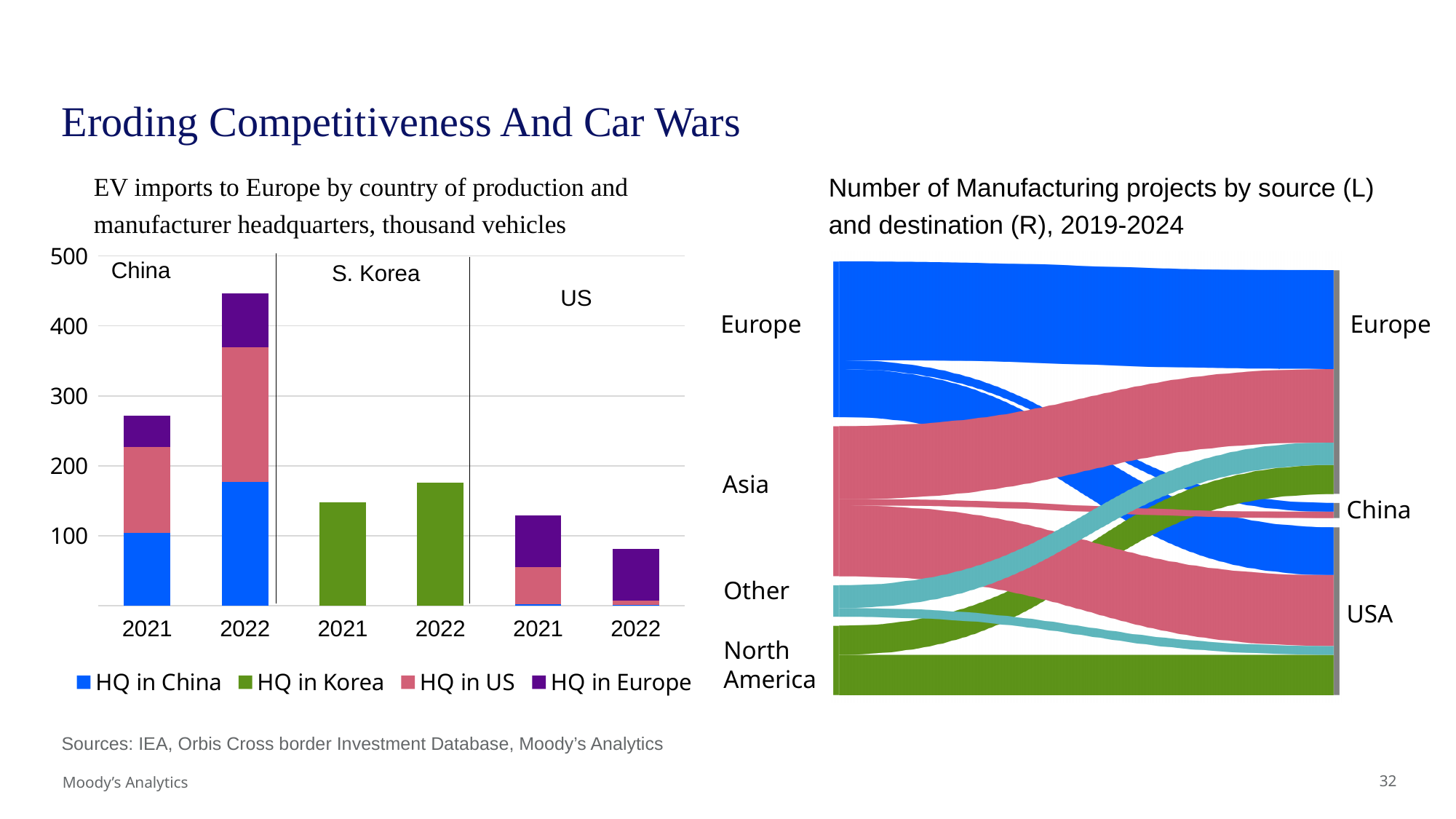
In the left chart on EV imports to Europe, which is larger: the total for China in 2021 or China in 2022? China in 2022 In the left chart on EV imports to Europe, is the total for US in 2022 greater or less than 100? less In the left chart on EV imports to Europe, which bar has the highest total? China 2022 In the left chart on EV imports to Europe, do the totals for the US rise or fall from 2021 to 2022? Fall In the right chart on the number of manufacturing projects, how many source regions are listed on the left side? 4 What kind of chart is the left chart, 'EV imports to Europe by country of production and manufacturer headquarters'? Bar chart In the left chart on EV imports to Europe, how many bars are plotted in total? 6 In the left chart on EV imports to Europe, is the total for S. Korea in 2021 greater or less than 200? less In the left chart on EV imports to Europe, is the total for China in 2022 greater or less than 400? greater In the left chart on EV imports to Europe, which legend entry is shown in green? HQ in Korea In the left chart on EV imports to Europe, how many series does the legend list? 4 In the left chart on EV imports to Europe, which bar has the lowest total? US 2022